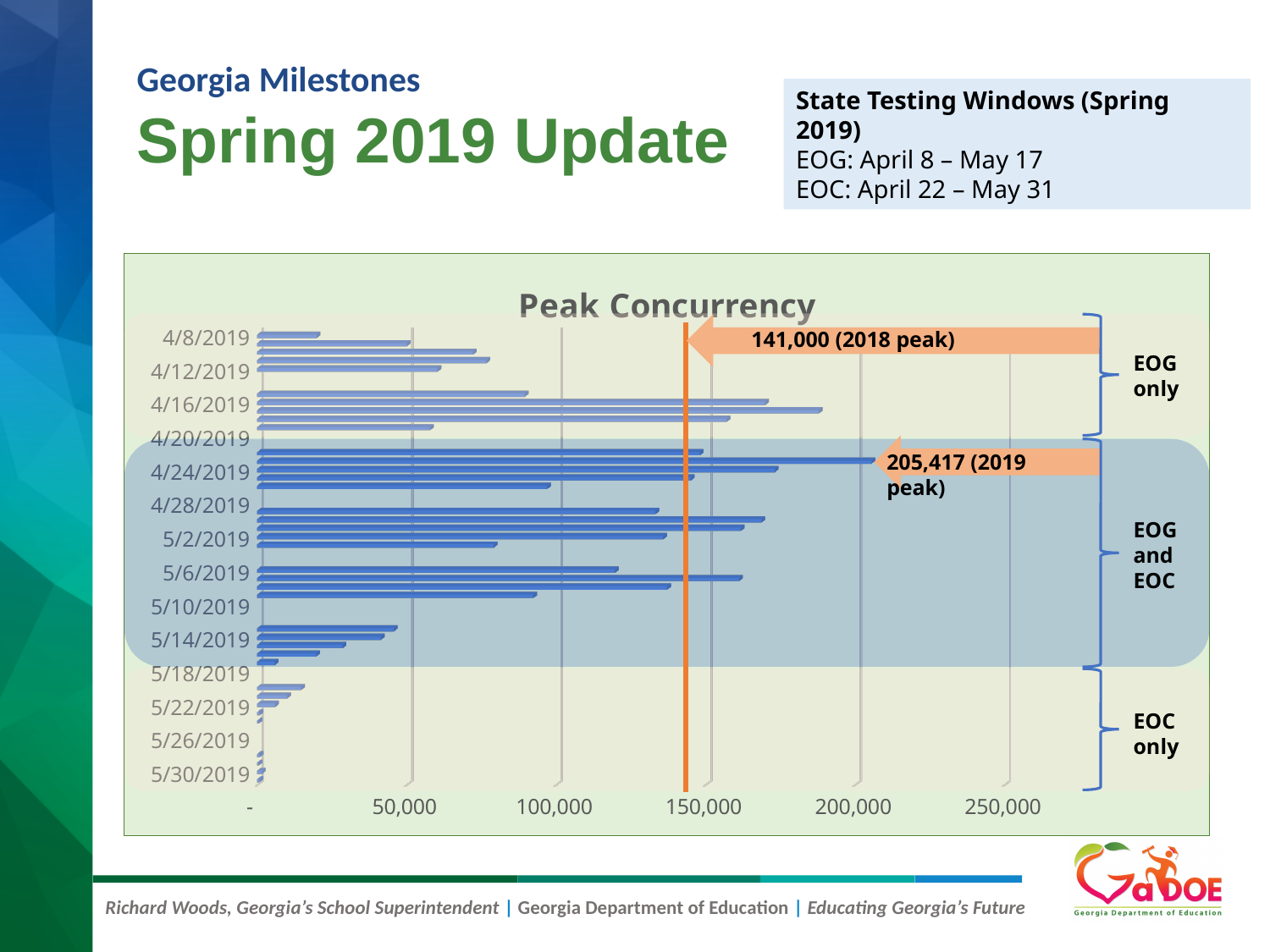
Is the value for 4/8/2019 greater or less than 50,000? less What is the title of the chart? Peak Concurrency Is the value for 5/22/2019 greater or less than 50,000? less What kind of chart is shown on the slide? bar chart What value is labeled as the 2019 peak on the chart? 205,417 Is the value for 4/12/2019 greater or less than 100,000? less Do the values generally rise or fall from 5/14/2019 to 5/30/2019? fall What is the difference between the 2019 peak and the 2018 peak shown on the chart? 64,417 What are the three testing window segments labeled to the right of the chart? EOG only, EOG and EOC, EOC only What value is labeled as the 2018 peak on the chart? 141,000 Which is larger, the 2019 peak or the 2018 peak? 2019 peak